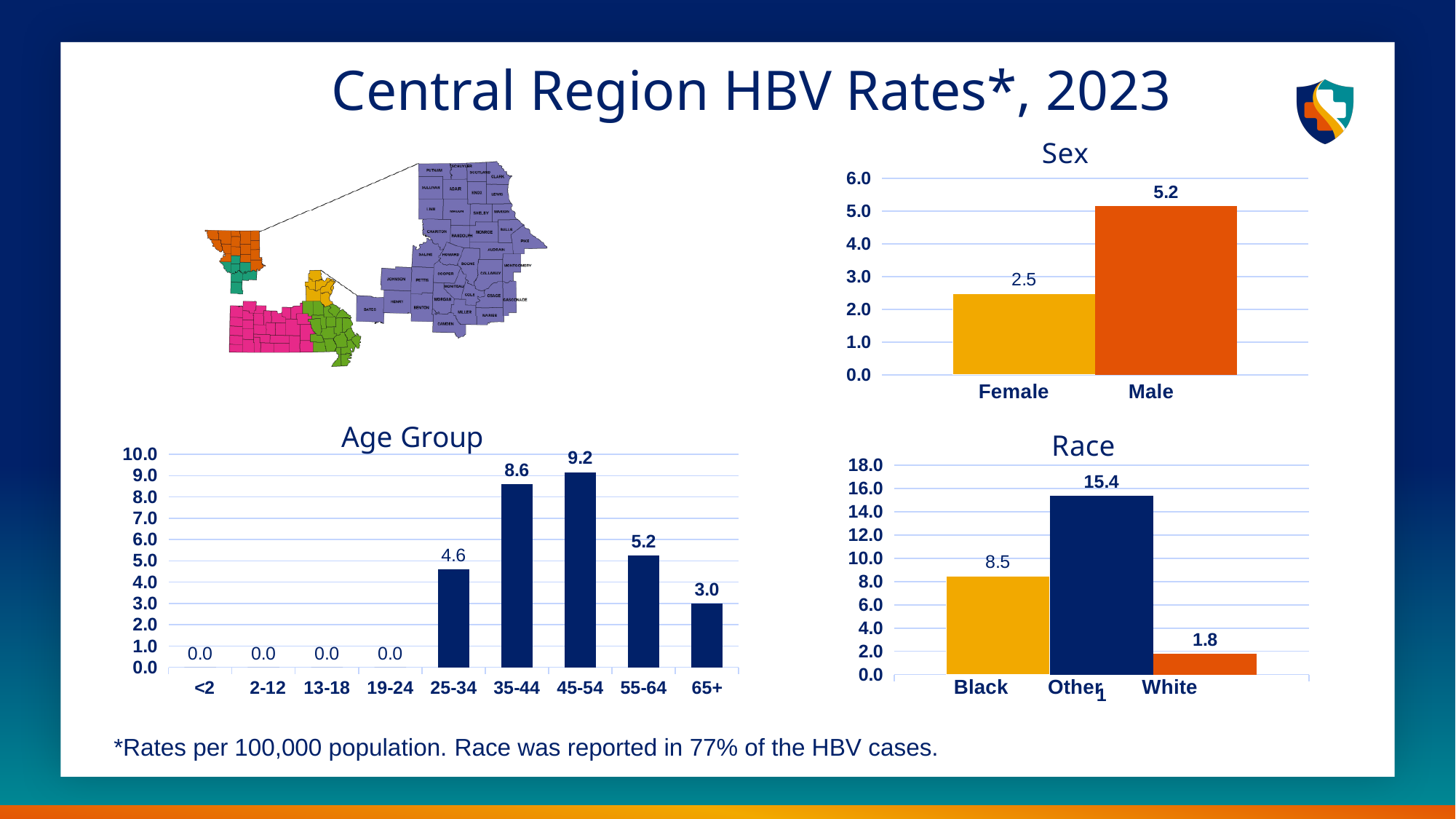
In the Race chart, which race category has the highest rate? Other In the Age Group chart, how many age group categories are shown on the x axis? 9 In the Age Group chart, what is the difference between the rates for 45-54 and 55-64? 4.0 In the Age Group chart, which is larger, the rate for 25-34 or the rate for 65+? 25-34 What kind of chart is the Race chart? Bar chart In the Sex chart, what is the difference between the Male and Female rates? 2.7 In the Sex chart, what is the HBV rate for Male? 5.2 In the Age Group chart, which age group has the highest rate? 45-54 In the Age Group chart, what is the rate for the 35-44 age group? 8.6 In the Sex chart, what is the HBV rate for Female? 2.5 In the Race chart, what is the rate for White? 1.8 In the Race chart, what is the difference between the rates for Other and Black? 6.9